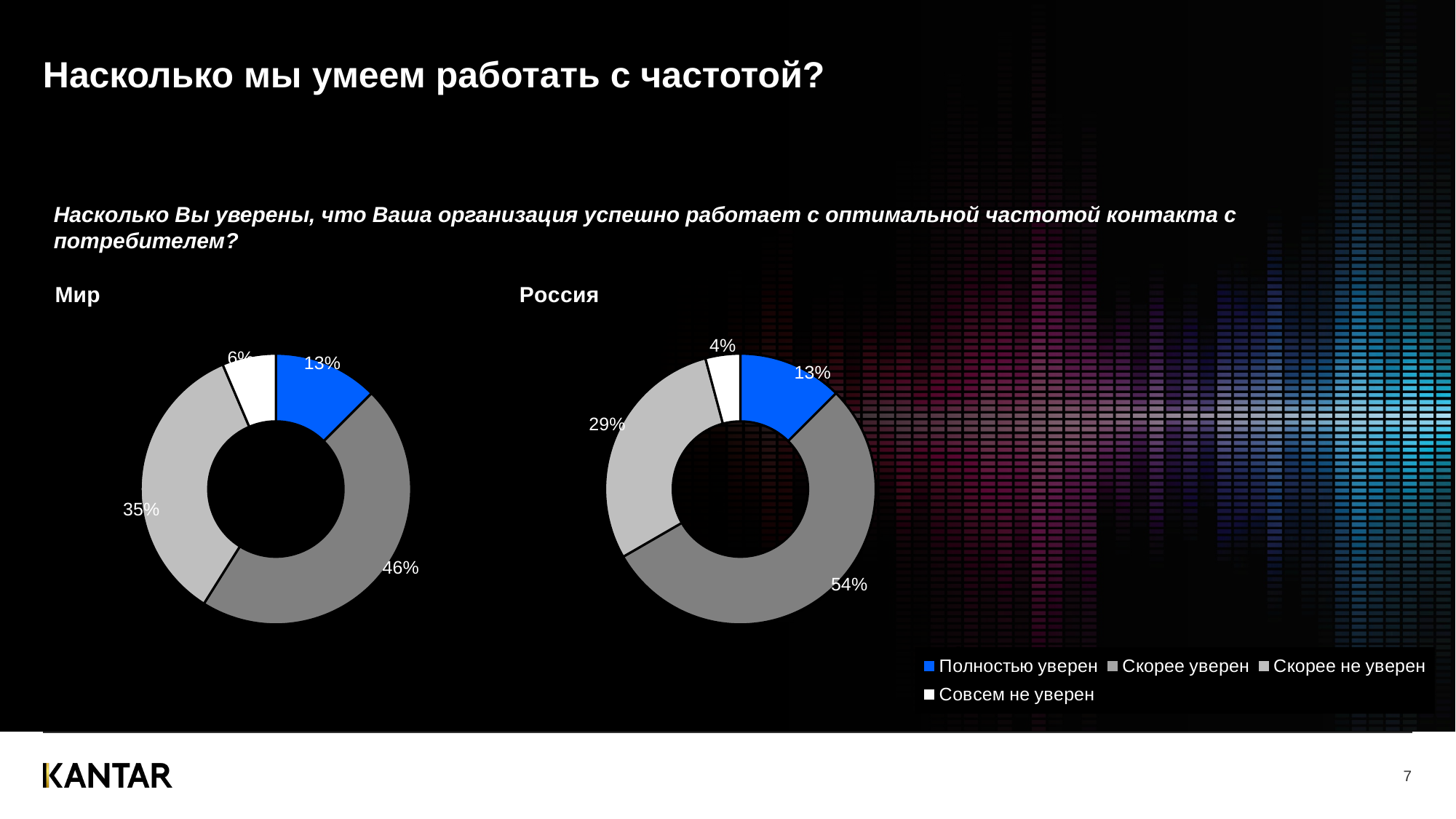
In the "Россия" chart, which category has the largest share? Скорее уверен In the "Россия" chart, what share is labelled for "Скорее уверен"? 54% What is the "Полностью уверен" share in the "Россия" chart? 13% In the "Россия" chart, what share is labelled for "Скорее не уверен"? 29% How many categories does the "Мир" chart show? 4 What is the difference between the "Скорее уверен" share in the "Россия" chart and in the "Мир" chart? 8% In the "Мир" chart, which category has the smallest share? Совсем не уверен Which colour represents "Полностью уверен" in the legend? Blue Which is larger: the "Скорее не уверен" share in the "Мир" chart or in the "Россия" chart? Мир In the "Мир" chart, what share is labelled for "Скорее уверен"? 46% What kind of chart is the "Россия" chart? Donut (pie) chart In the "Мир" chart, what share is labelled for "Совсем не уверен"? 6%